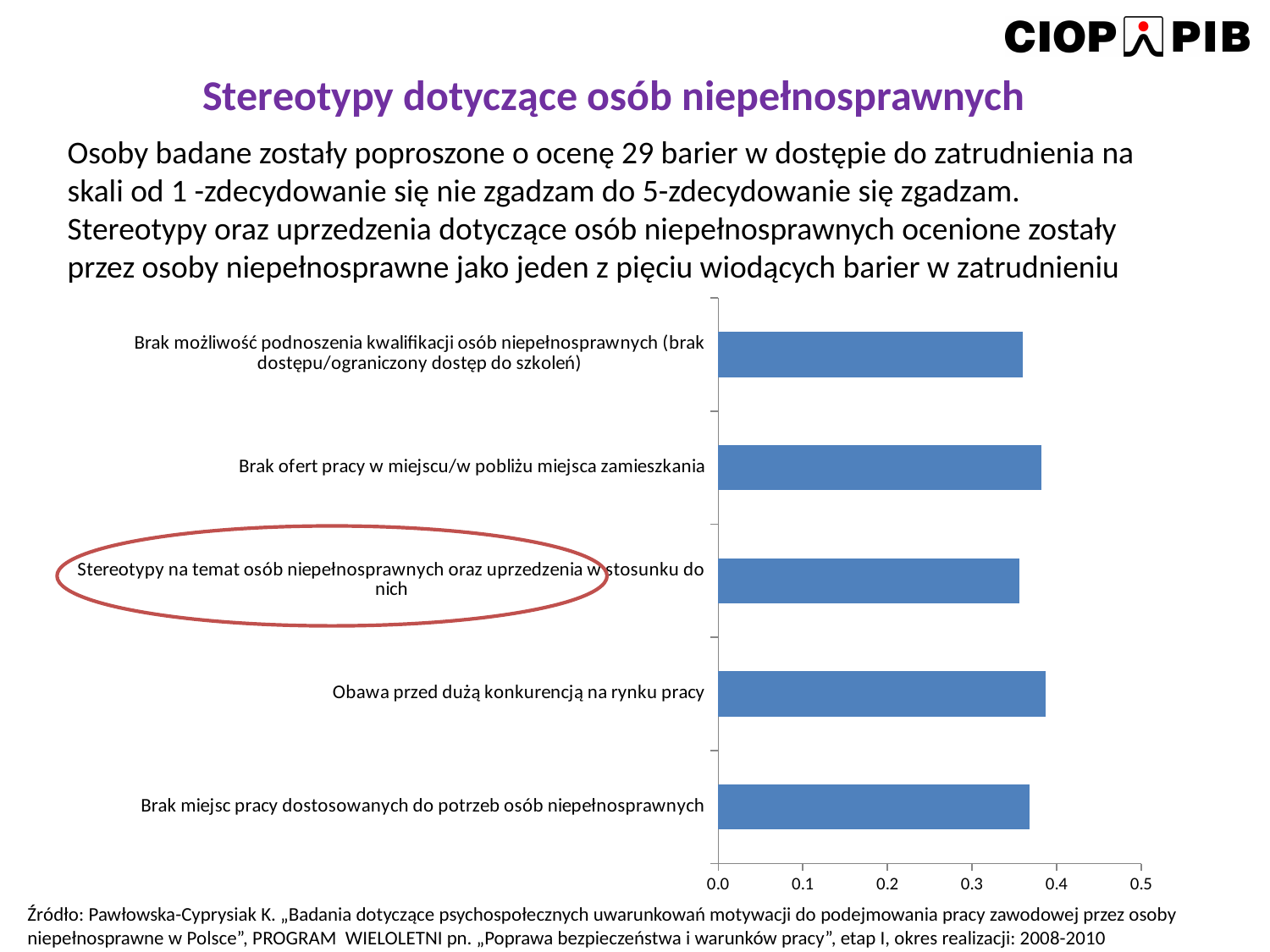
What is the maximum value shown on the horizontal axis of the chart? 0.5 Which has the larger value: "Obawa przed dużą konkurencją na rynku pracy" or "Stereotypy na temat osób niepełnosprawnych oraz uprzedzenia w stosunku do nich"? Obawa przed dużą konkurencją na rynku pracy Is the value for "Brak ofert pracy w miejscu/w pobliżu miejsca zamieszkania" greater or less than 0.4? less Is the value for "Brak miejsc pracy dostosowanych do potrzeb osób niepełnosprawnych" greater or less than 0.3? greater What kind of chart is shown on the slide? bar chart Is the value for "Obawa przed dużą konkurencją na rynku pracy" greater or less than 0.3? greater How many categories (bars) does the chart show? 5 Which has the larger value: "Brak ofert pracy w miejscu/w pobliżu miejsca zamieszkania" or "Stereotypy na temat osób niepełnosprawnych oraz uprzedzenia w stosunku do nich"? Brak ofert pracy w miejscu/w pobliżu miejsca zamieszkania Which category label on the chart is circled in red? Stereotypy na temat osób niepełnosprawnych oraz uprzedzenia w stosunku do nich